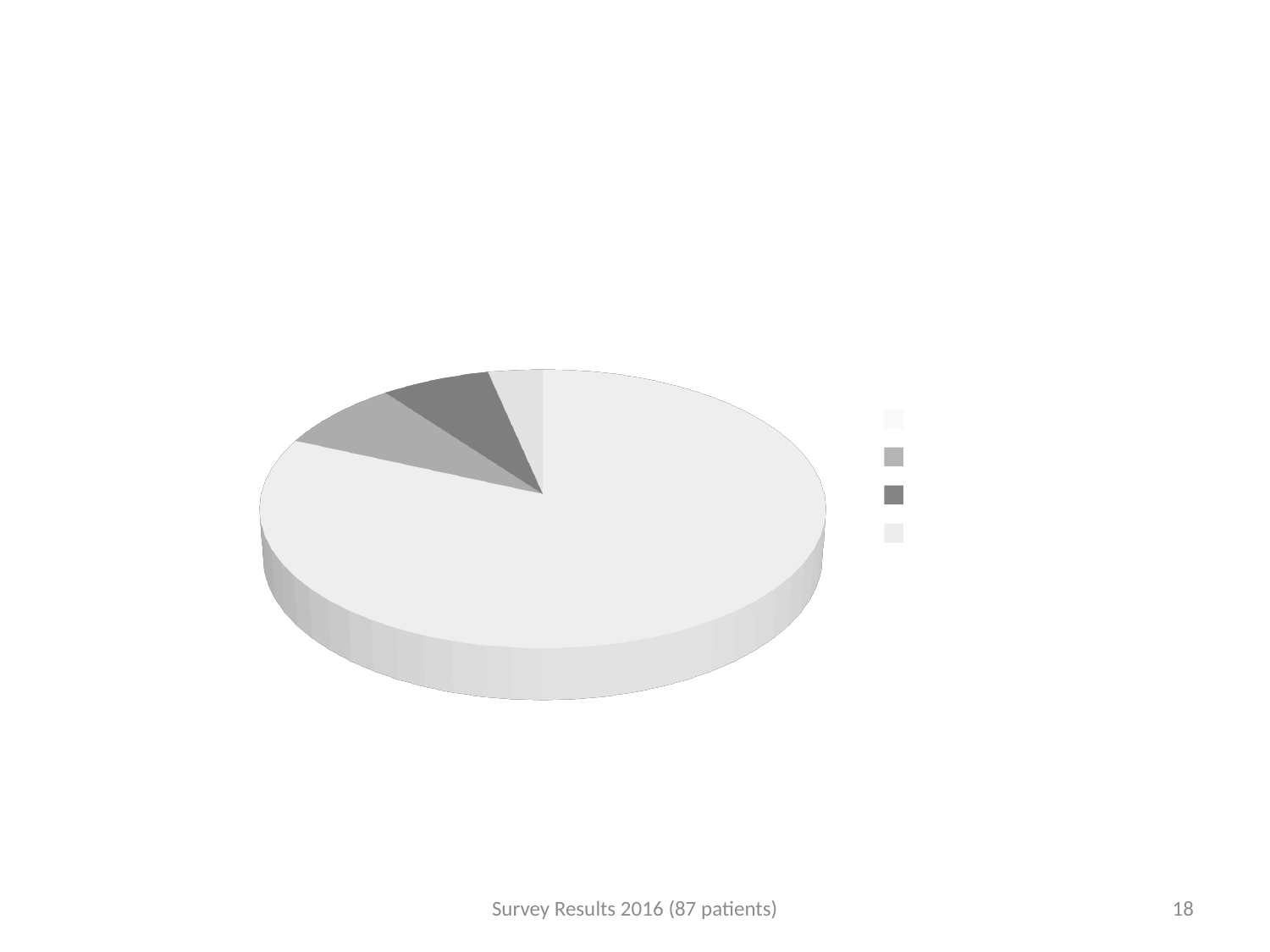
Is the pie chart drawn in 3D or flat 2D? 3D What kind of chart is shown on the slide? pie chart Does the largest slice of the pie chart take up more or less than half of the pie? more How many entries does the legend of the pie chart list? 4 How many slices does the pie chart have? 4